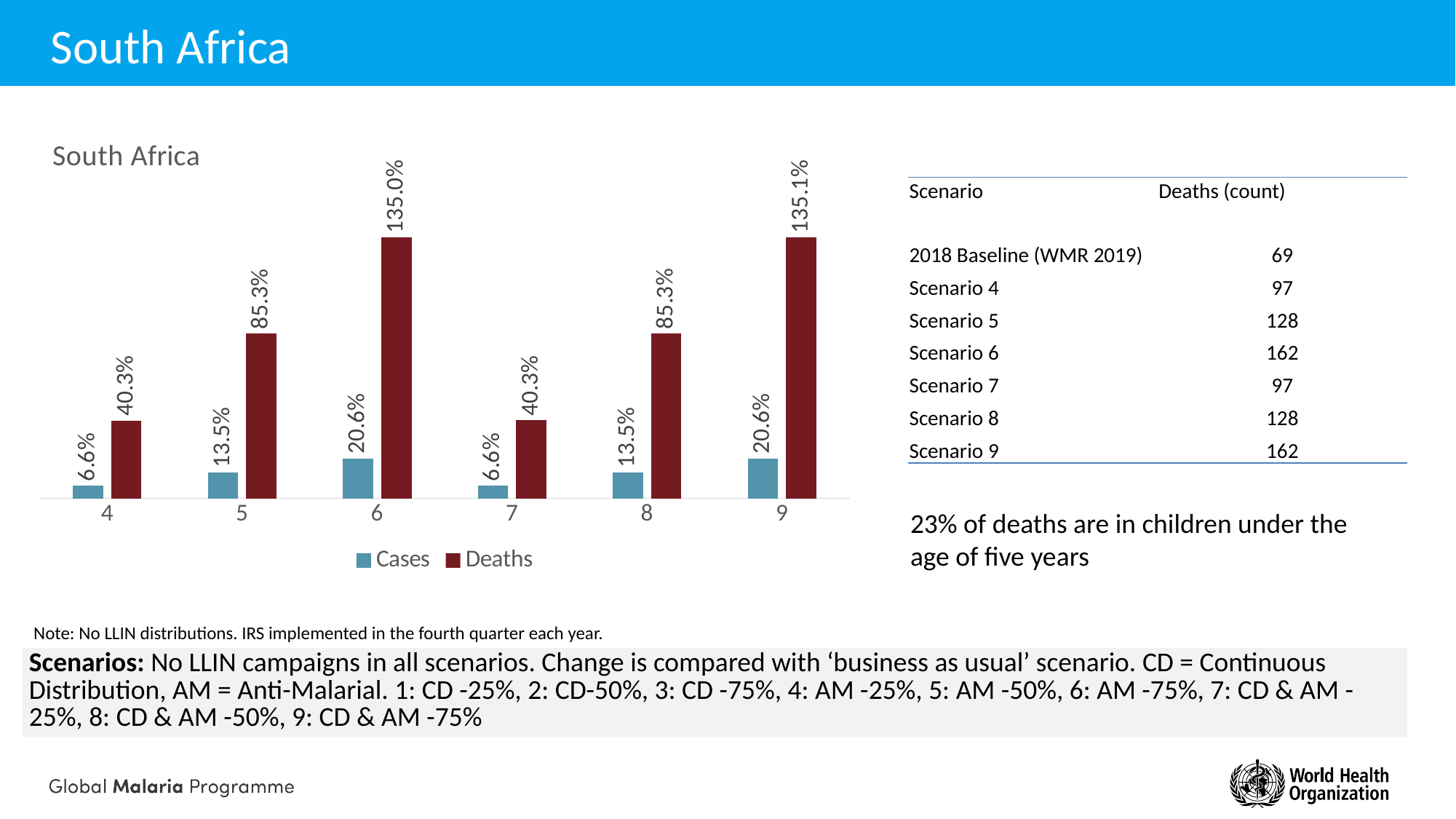
Which scenarios have the lowest Cases value? 4 and 7 Is the Deaths value for scenario 5 larger than the Deaths value for scenario 4? Yes How many scenarios are shown on the x axis of the chart? 6 What is the Cases value for scenario 5? 13.5% What kind of chart is shown on the slide? Bar chart Which scenario has the highest Deaths value? 9 What is the Deaths value for scenario 6? 135.0% Which series is shown in dark red in the chart? Deaths What is the difference between the Deaths value and the Cases value for scenario 8? 71.8% How many series does the chart legend list? 2 What is the Cases value for scenario 7? 6.6% What is the Deaths value for scenario 9? 135.1%